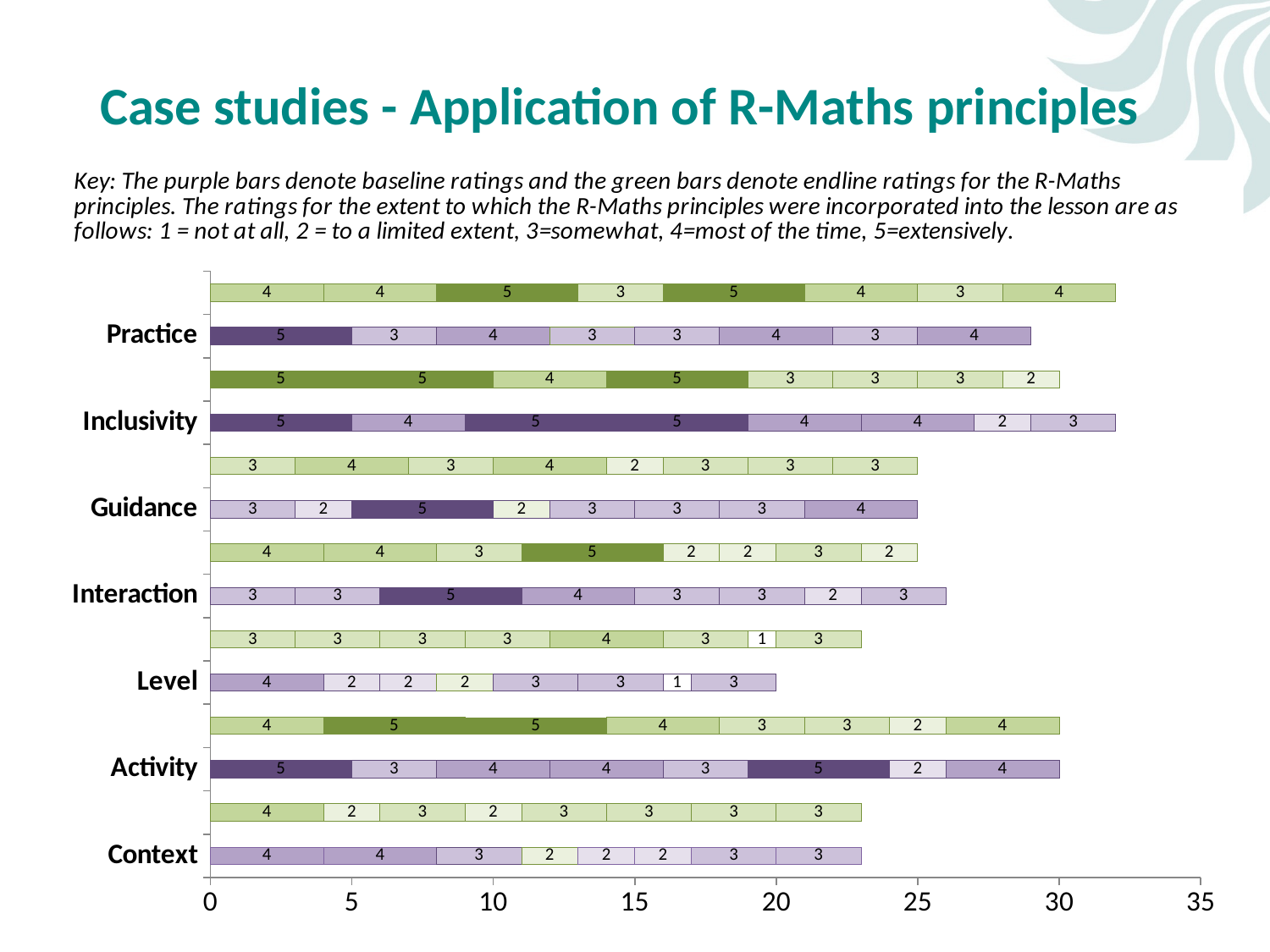
What is the difference between the total of the green endline bar and the purple baseline bar for Level? 3 How many R-Maths principles (categories) are listed on the vertical axis of the chart? 7 Which principle has the shortest purple baseline bar? Level Which principle has the longest green endline bar? Practice Which is longer for Practice: the green endline bar or the purple baseline bar? the green endline bar What is the total of the purple baseline bar for Level? 20 What kind of chart is shown on the slide? stacked bar chart What is the value of the first (leftmost) segment of the purple baseline bar for Practice? 5 Is the total of the green endline bar for Level greater or less than 25? less What is the total of the green endline bar for Practice? 32 What is the value of the first (leftmost) segment of the green endline bar for Inclusivity? 5 What is the total of the purple baseline bar for Inclusivity? 32